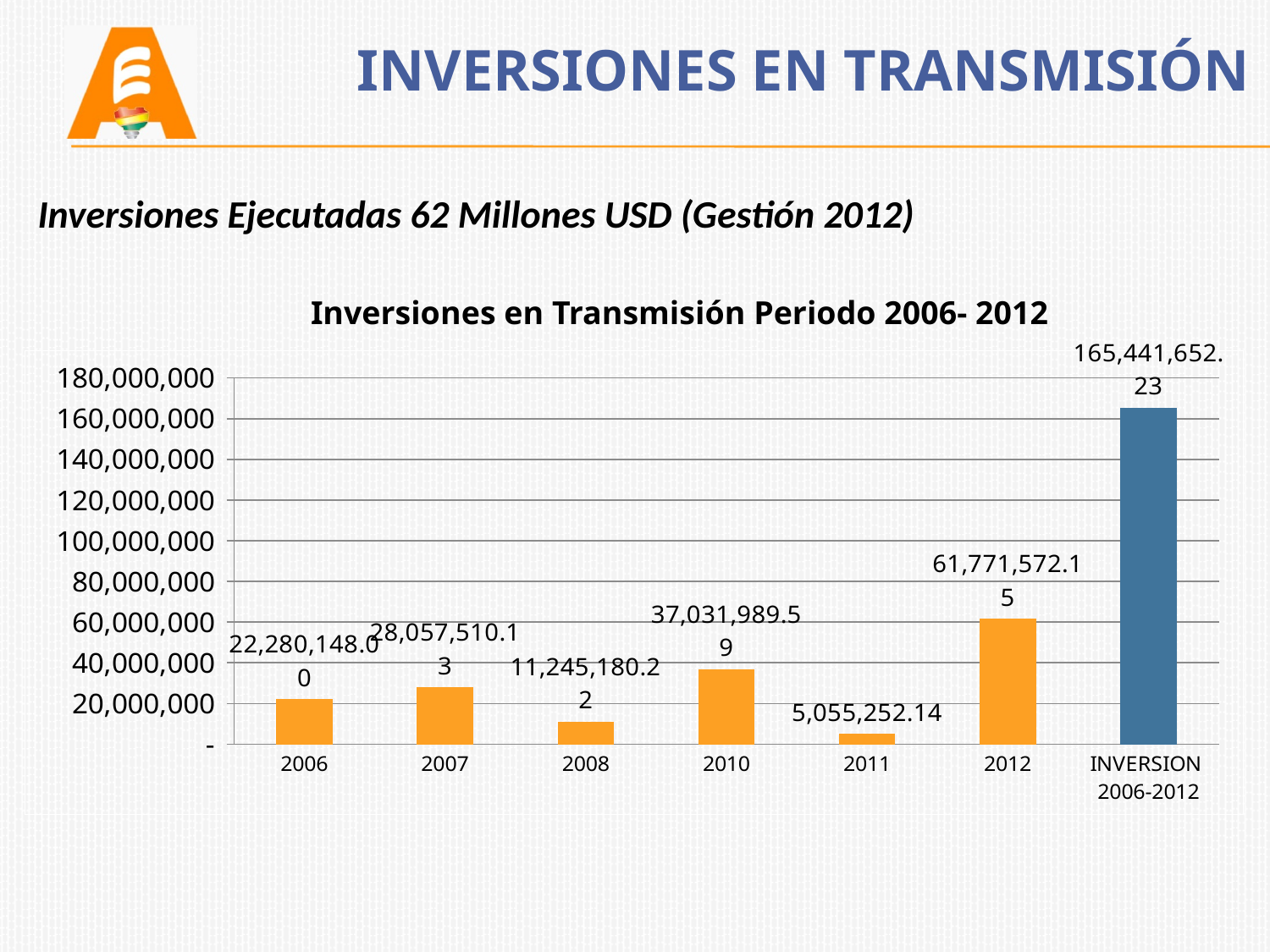
What type of chart is shown on the slide? Bar chart Is the value for 2010 greater or less than 40,000,000? less How many bars are plotted in the chart? 7 Which is larger, the value for 2007 or the value for 2008? 2007 What is the value for 2011 in the chart? 5,055,252.14 Which category has the lowest value in the chart? 2011 What is the title of the chart? Inversiones en Transmisión Periodo 2006- 2012 Among the individual years shown, which year has the highest investment? 2012 What is the value for 2012 in the chart? 61,771,572.15 What is the difference between the values for 2012 and 2011? 56,716,320.01 What is the value for INVERSION 2006-2012 in the chart? 165,441,652.23 What is the value for 2006 in the chart? 22,280,148.00